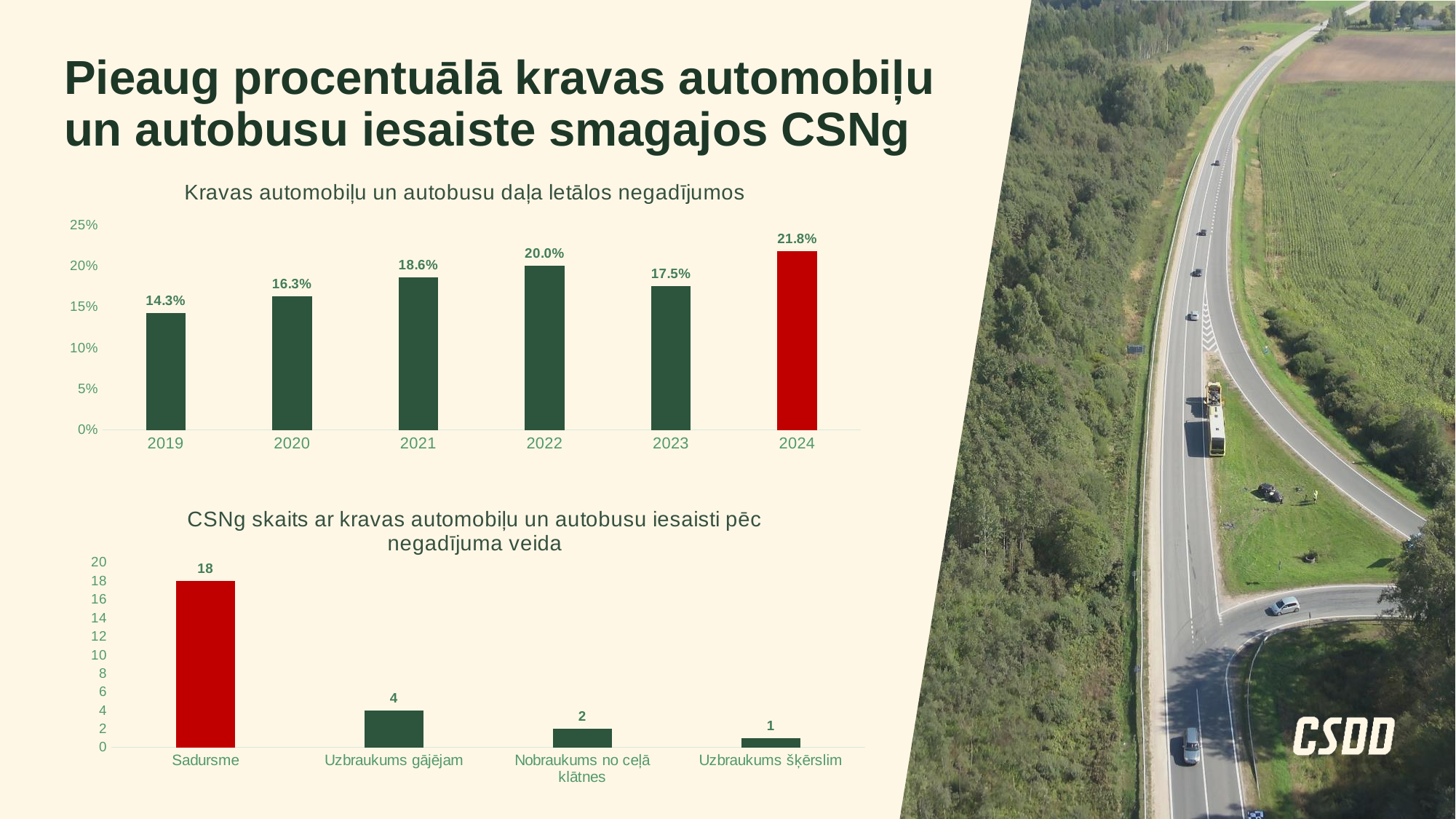
In the chart 'Kravas automobiļu un autobusu daļa letālos negadījumos', how many years are shown? 6 In the chart 'Kravas automobiļu un autobusu daļa letālos negadījumos', what colour is the bar for 2024? Red In the chart 'CSNg skaits ar kravas automobiļu un autobusu iesaisti pēc negadījuma veida', what is the value for Sadursme? 18 In the chart 'Kravas automobiļu un autobusu daļa letālos negadījumos', which year has the highest value? 2024 In the chart 'Kravas automobiļu un autobusu daļa letālos negadījumos', which year has the lowest value? 2019 In the chart 'CSNg skaits ar kravas automobiļu un autobusu iesaisti pēc negadījuma veida', which category has the lowest value? Uzbraukums šķērslim What kind of chart is the bottom chart on the slide? Bar chart In the chart 'Kravas automobiļu un autobusu daļa letālos negadījumos', which is larger, the value for 2021 or the value for 2023? 2021 In the chart 'Kravas automobiļu un autobusu daļa letālos negadījumos', what is the difference between the values for 2022 and 2023? 2.5% In the chart 'Kravas automobiļu un autobusu daļa letālos negadījumos', what is the value for 2024? 21.8% In the chart 'CSNg skaits ar kravas automobiļu un autobusu iesaisti pēc negadījuma veida', what is the difference between Sadursme and Uzbraukums gājējam? 14 In the chart 'Kravas automobiļu un autobusu daļa letālos negadījumos', what is the value for 2019? 14.3%